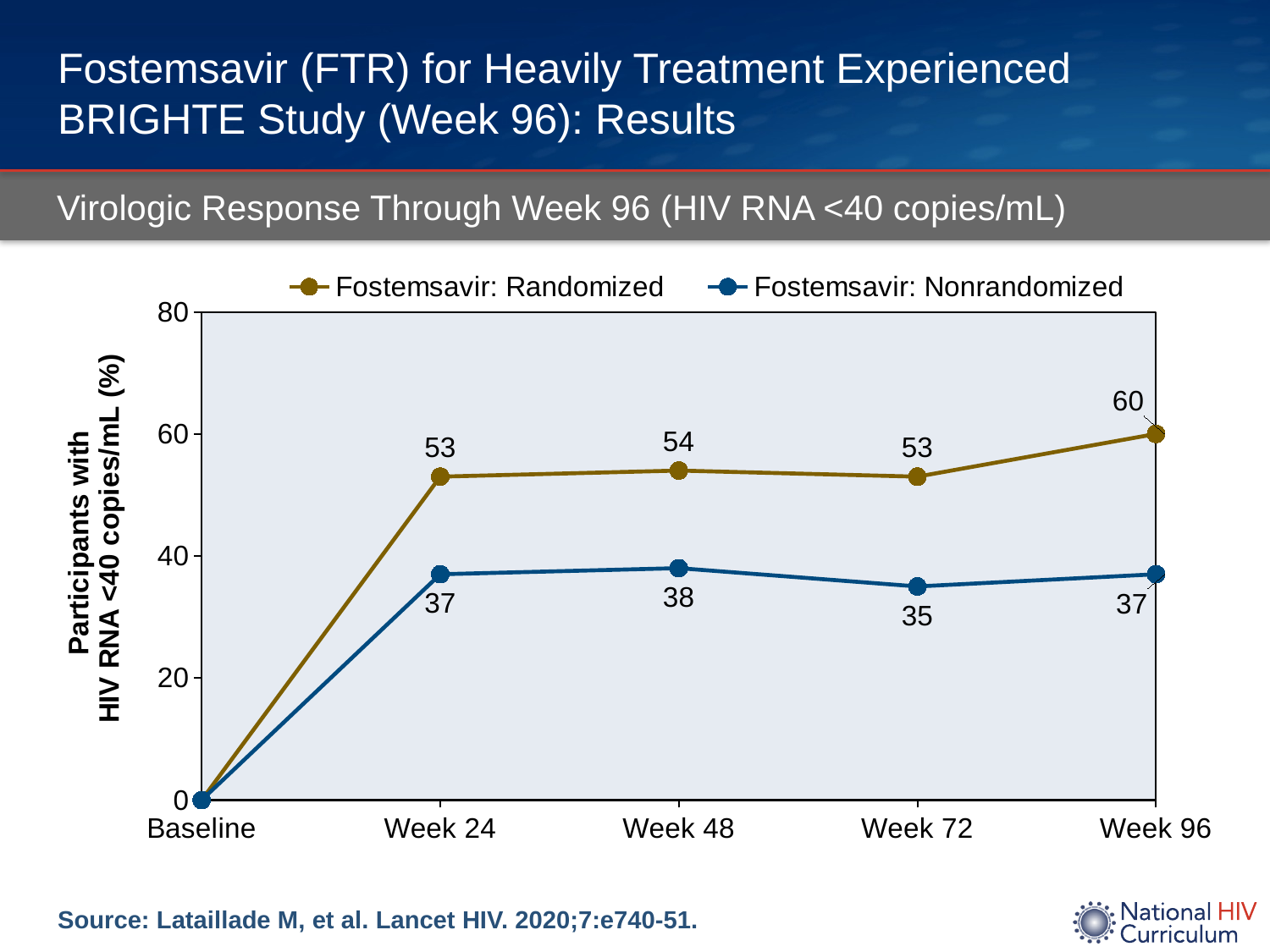
At which time point after Baseline is the Fostemsavir: Nonrandomized series lowest? Week 72 Which series has the larger value at Week 48, Fostemsavir: Randomized or Fostemsavir: Nonrandomized? Fostemsavir: Randomized What is the value for Fostemsavir: Nonrandomized at Week 72? 35 What is the value for Fostemsavir: Randomized at Week 96? 60 What is the difference between the Fostemsavir: Randomized and Fostemsavir: Nonrandomized values at Week 96? 23 How many time points are shown on the x axis? 5 What is the label of the y axis? Participants with HIV RNA <40 copies/mL (%) How many series does the legend list? 2 At which time point is the Fostemsavir: Randomized series highest? Week 96 What is the value for Fostemsavir: Randomized at Week 48? 54 What is the value for Fostemsavir: Nonrandomized at Week 24? 37 What kind of chart is shown on the slide? Line chart